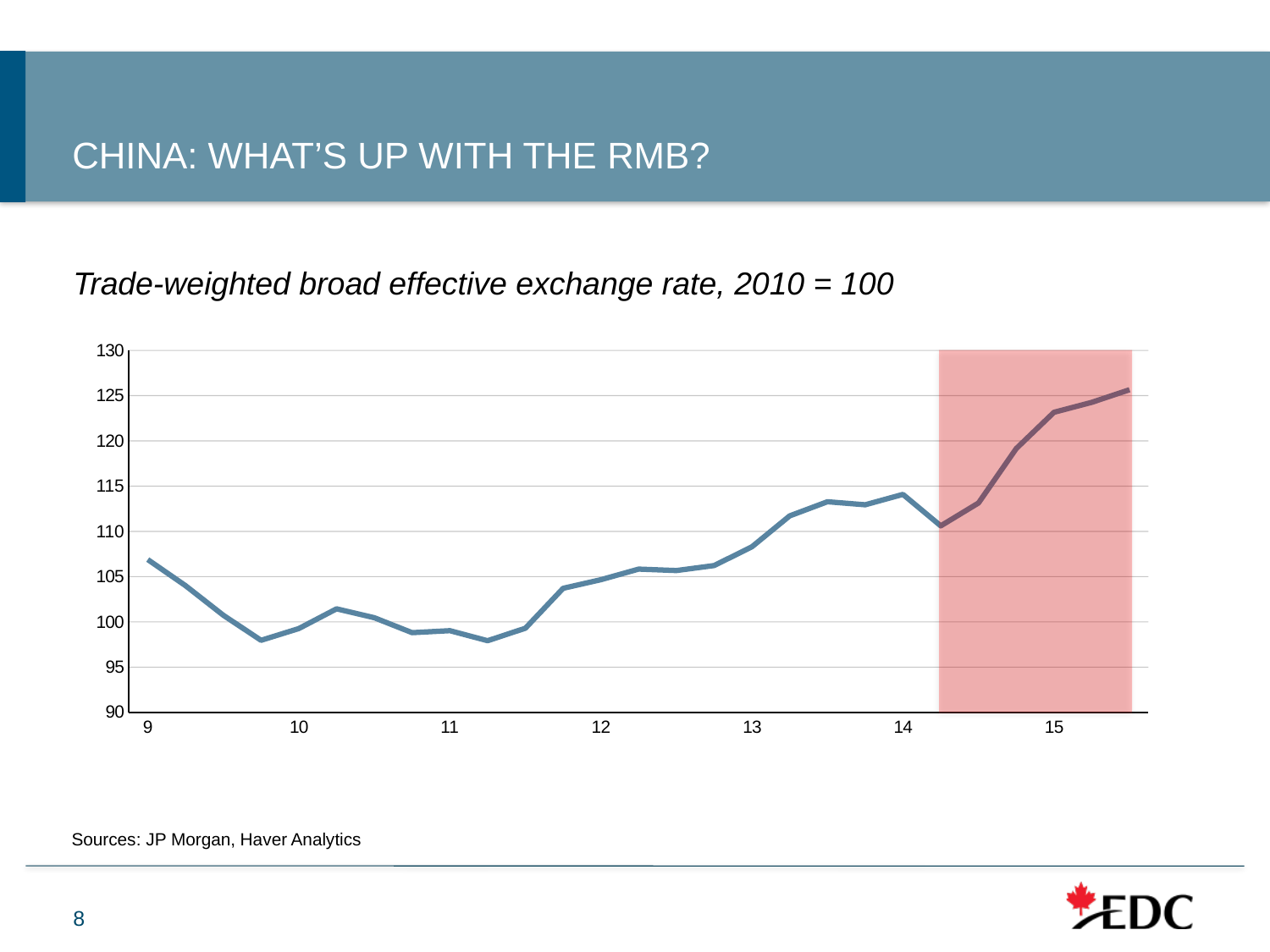
Does the line rise or fall between 9 and 10 on the x axis? fall Where does the line reach its highest point? at the end of the series, after 15 Is the value at 14 greater or less than 110? greater Is the value at 13 greater or less than 105? greater What is the title of the chart? Trade-weighted broad effective exchange rate, 2010 = 100 Is the value at the end of the series greater or less than 120? greater How many year labels are shown on the x axis? 7 Which is larger, the value at 9 or the value at 10? the value at 9 Does the line rise or fall from 14 to the end of the series? rise What kind of chart is shown on the slide? line chart